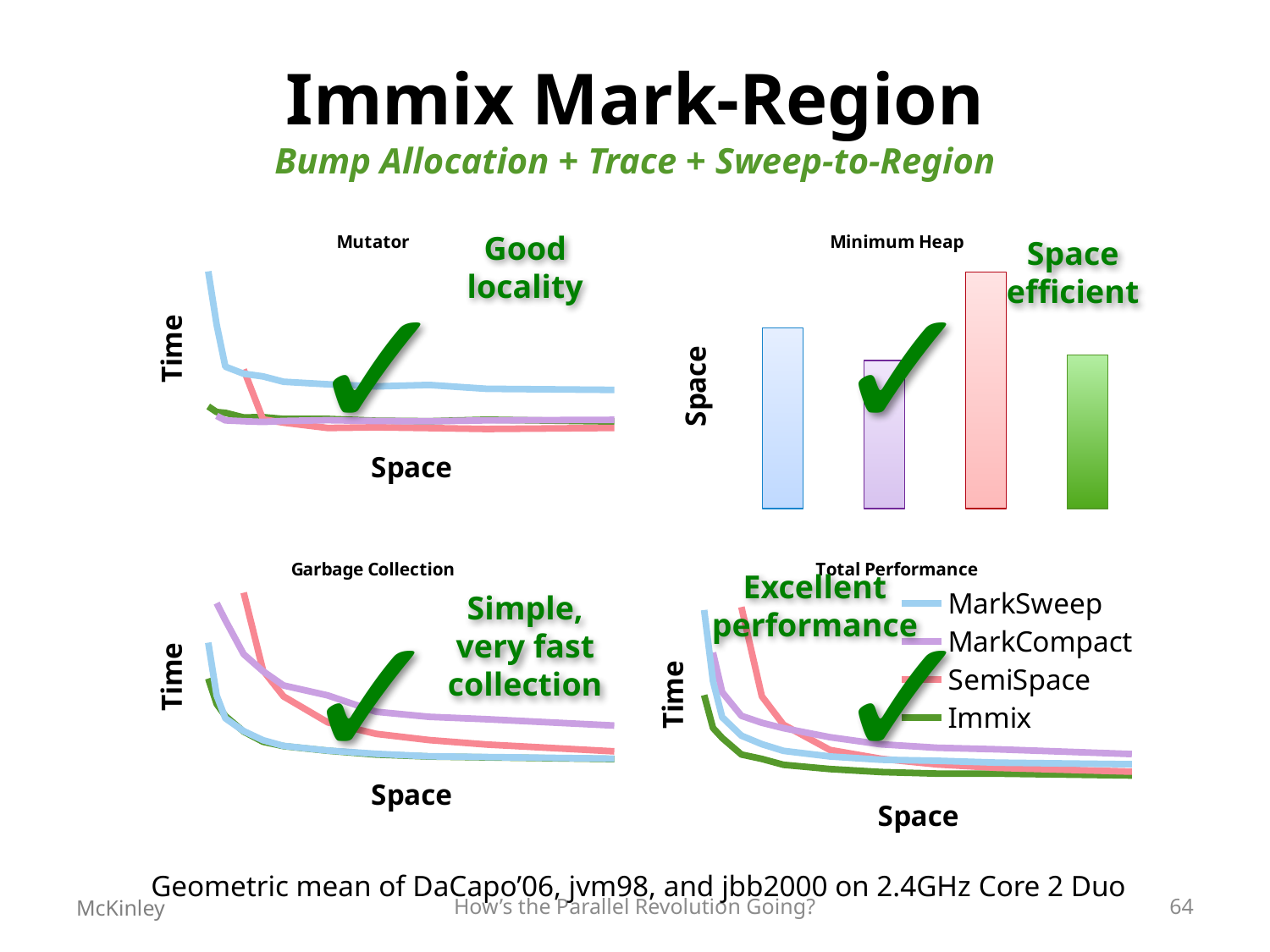
What kind of chart is the Minimum Heap chart? bar chart In the Minimum Heap chart, is the SemiSpace (red) bar taller or shorter than the MarkSweep (blue) bar? taller In the Garbage Collection chart, does Time rise or fall as Space increases? fall In the Minimum Heap chart, is the MarkSweep (blue) bar taller or shorter than the MarkCompact (purple) bar? taller How many bars are shown in the Minimum Heap chart? 4 In the Total Performance chart, does Time rise or fall as Space increases? fall How many series does the legend on the Total Performance chart list? 4 What kind of chart is the Total Performance chart? line chart Which series is drawn in green in the Total Performance chart legend? Immix What is the label on the y axis of the Mutator chart? Time In the Minimum Heap chart, which series has the tallest bar? SemiSpace How many charts are shown on the slide? 4